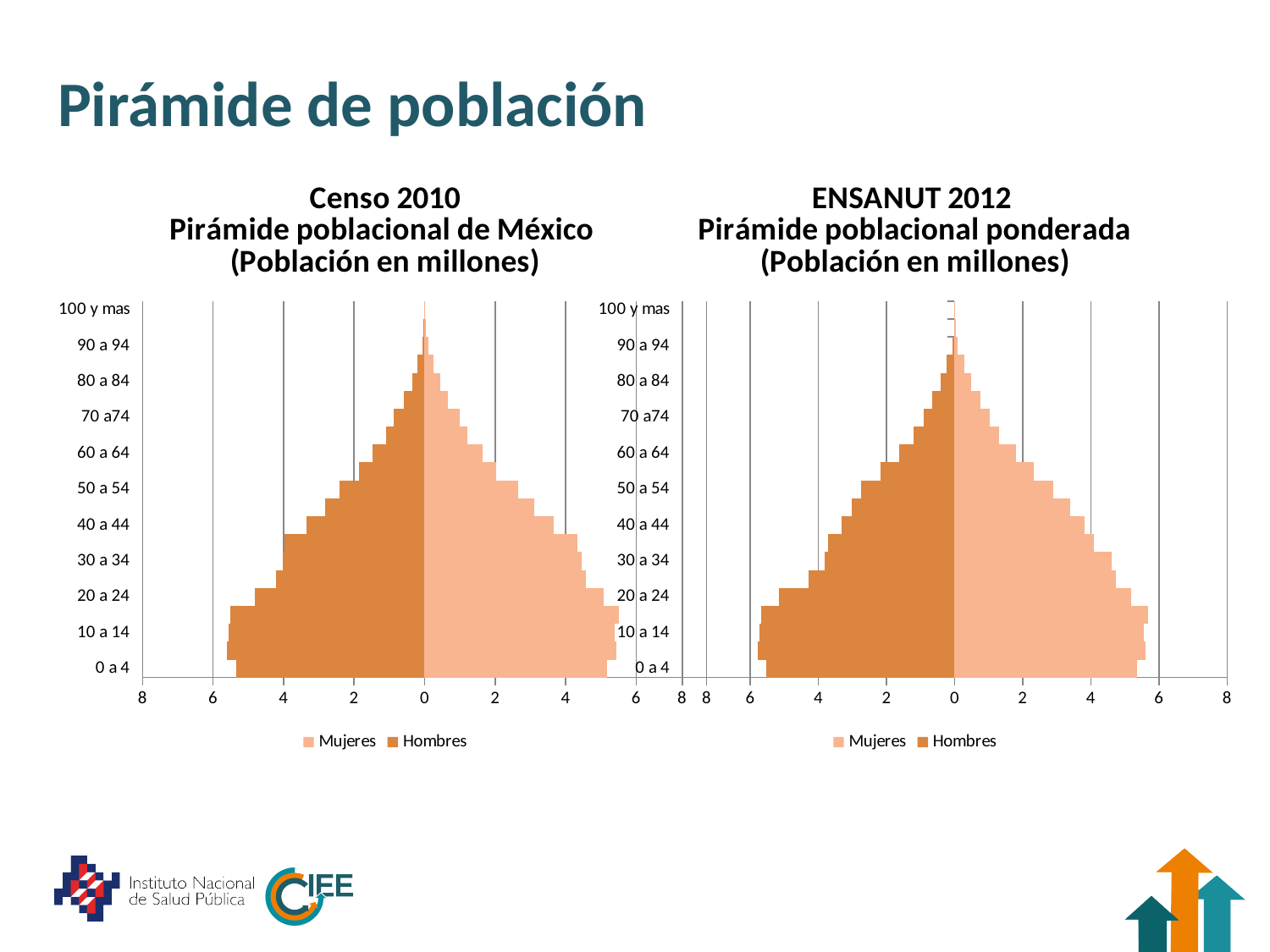
How many series does the legend of the ENSANUT 2012 chart list? 2 What kind of chart is the Censo 2010 chart on the left? bar chart What are the two series named in the legend of the Censo 2010 chart? Mujeres and Hombres In the ENSANUT 2012 chart, do the Mujeres values rise or fall as the age groups get older? fall What unit of population do both chart titles say the values are in? millones In the ENSANUT 2012 chart, which age group has the smallest Hombres value? 100 y mas In the Censo 2010 chart, is the Mujeres value for the 80 a 84 age group greater or less than 2? less In the Censo 2010 chart, is the Hombres value for the 0 a 4 age group greater or less than 4? greater In the Censo 2010 chart, which is larger for Hombres: the 0 a 4 age group or the 60 a 64 age group? 0 a 4 In the Censo 2010 chart, is the Hombres value for the 60 a 64 age group greater or less than 2? less